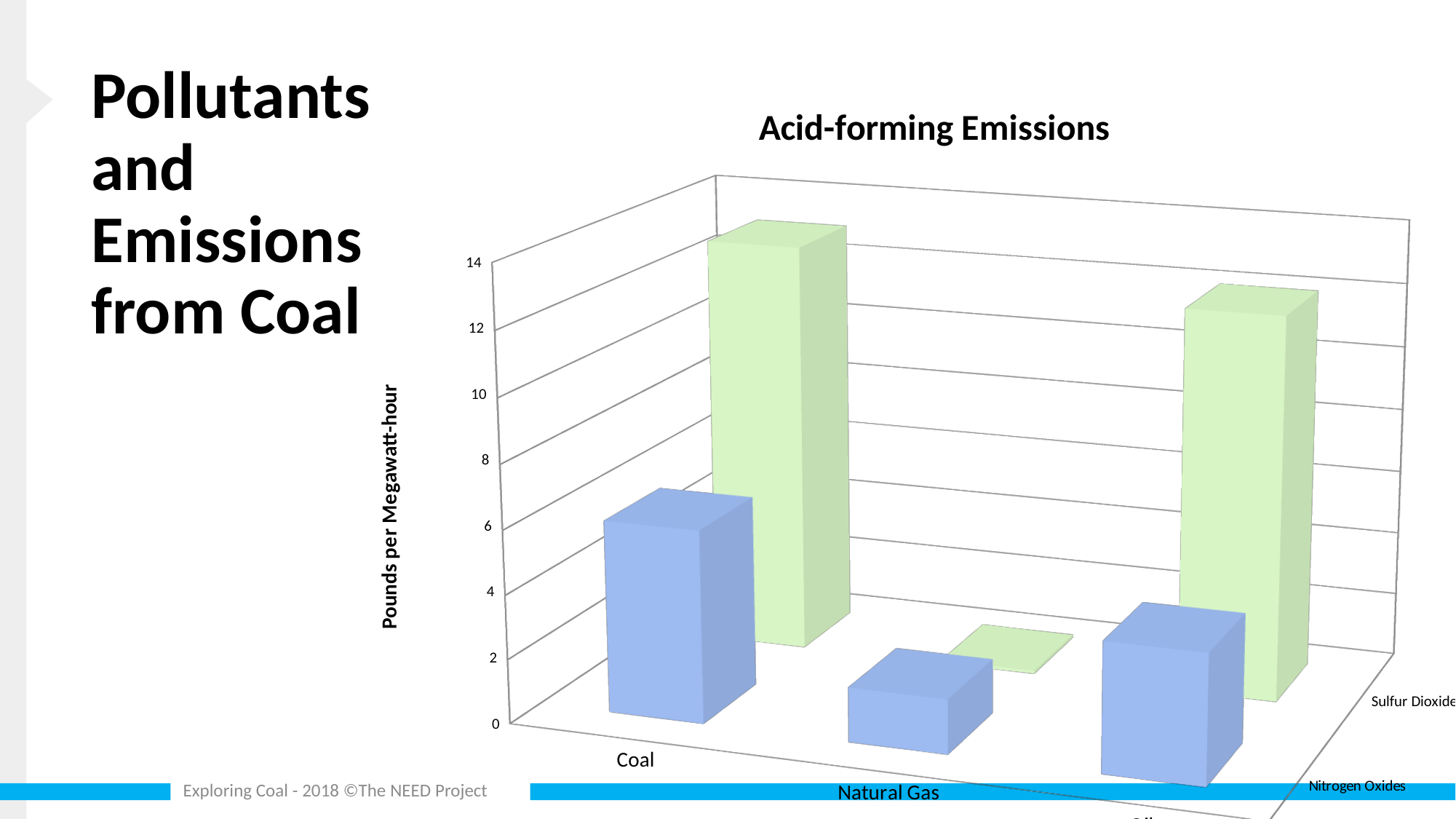
Which fuel has the lowest Sulfur Dioxide emissions? Natural Gas What is the label on the vertical axis of the chart? Pounds per Megawatt-hour Is the Nitrogen Oxides value for Natural Gas greater or less than 4? less Which is larger, the Nitrogen Oxides value for Coal or for Natural Gas? Coal Is the Sulfur Dioxide value for Natural Gas greater or less than 2? less What kind of chart is shown on the slide? bar chart How many pollutant series are plotted in the chart? 2 How many fuel categories are shown along the horizontal axis of the chart? 3 Is the Nitrogen Oxides value for Coal greater or less than 4? greater What is the title of the chart? Acid-forming Emissions For Coal, which is larger, the Sulfur Dioxide value or the Nitrogen Oxides value? Sulfur Dioxide